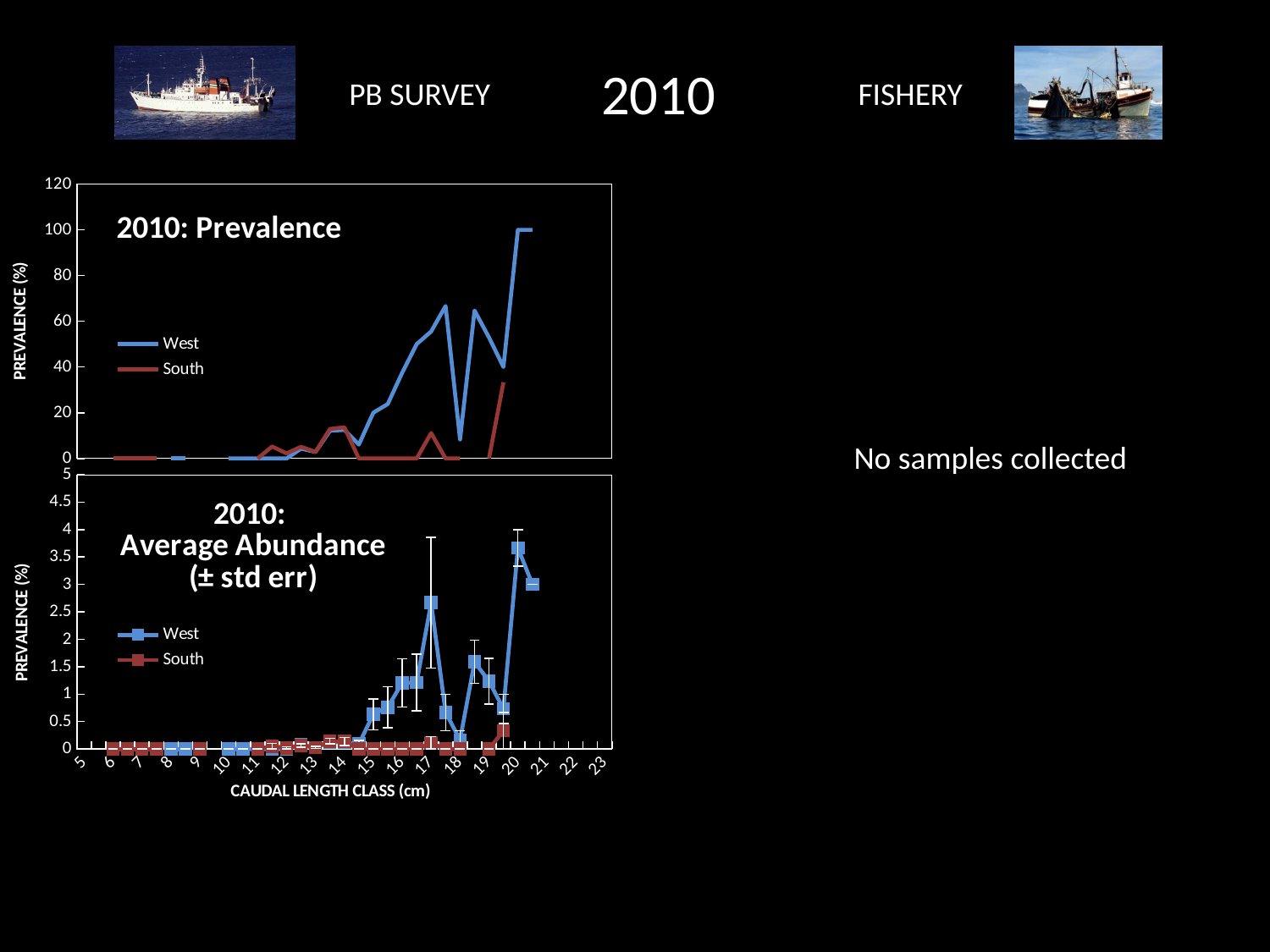
In the top chart "2010: Prevalence", does the West series generally rise or fall as caudal length class increases from 14 to 20? rise In the bottom chart "2010: Average Abundance (± std err)", is the value for West at caudal length class 20 greater or less than 3? greater What colour is the South series drawn in on the top chart "2010: Prevalence"? red In the top chart "2010: Prevalence", what is the highest prevalence value reached by the West series? 100 How many series does the legend of the top chart "2010: Prevalence" list? 2 In the bottom chart "2010: Average Abundance (± std err)", is the value for West at caudal length class 17 greater or less than 2? greater What is the x-axis label of the bottom chart "2010: Average Abundance (± std err)"? CAUDAL LENGTH CLASS (cm) In the top chart "2010: Prevalence", is the value for West at caudal length class 17 greater or less than 40? greater In the top chart "2010: Prevalence", which series reaches the highest prevalence value? West What kind of chart is the top chart titled "2010: Prevalence"? line chart